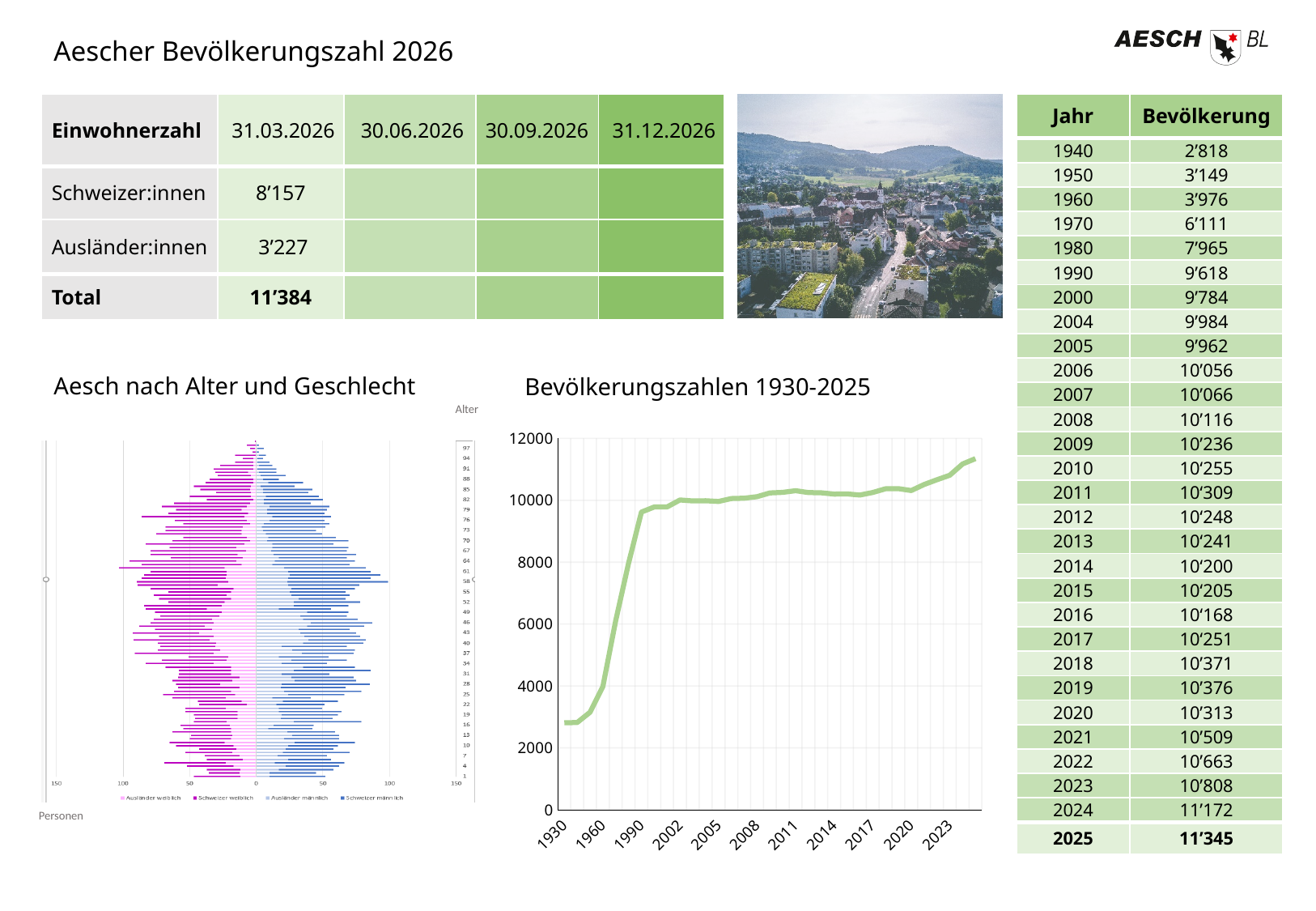
What is the first year shown on the x axis of 'Bevölkerungszahlen 1930-2025'? 1930 What is the highest value shown on the y axis of 'Bevölkerungszahlen 1930-2025'? 12000 In the chart 'Bevölkerungszahlen 1930-2025', is the value for 1990 greater or less than 8000? greater How many series does the legend of 'Aesch nach Alter und Geschlecht' list? 4 In the chart 'Bevölkerungszahlen 1930-2025', is the value for 2023 greater or less than 10000? greater What kind of chart is 'Aesch nach Alter und Geschlecht'? bar chart In the chart 'Bevölkerungszahlen 1930-2025', do the values rise or fall between 1930 and 1990? rise In the chart 'Bevölkerungszahlen 1930-2025', is the value for 1930 greater or less than 4000? less What kind of chart is 'Bevölkerungszahlen 1930-2025'? line chart In the chart 'Bevölkerungszahlen 1930-2025', which is larger, the value for 1960 or the value for 2005? 2005